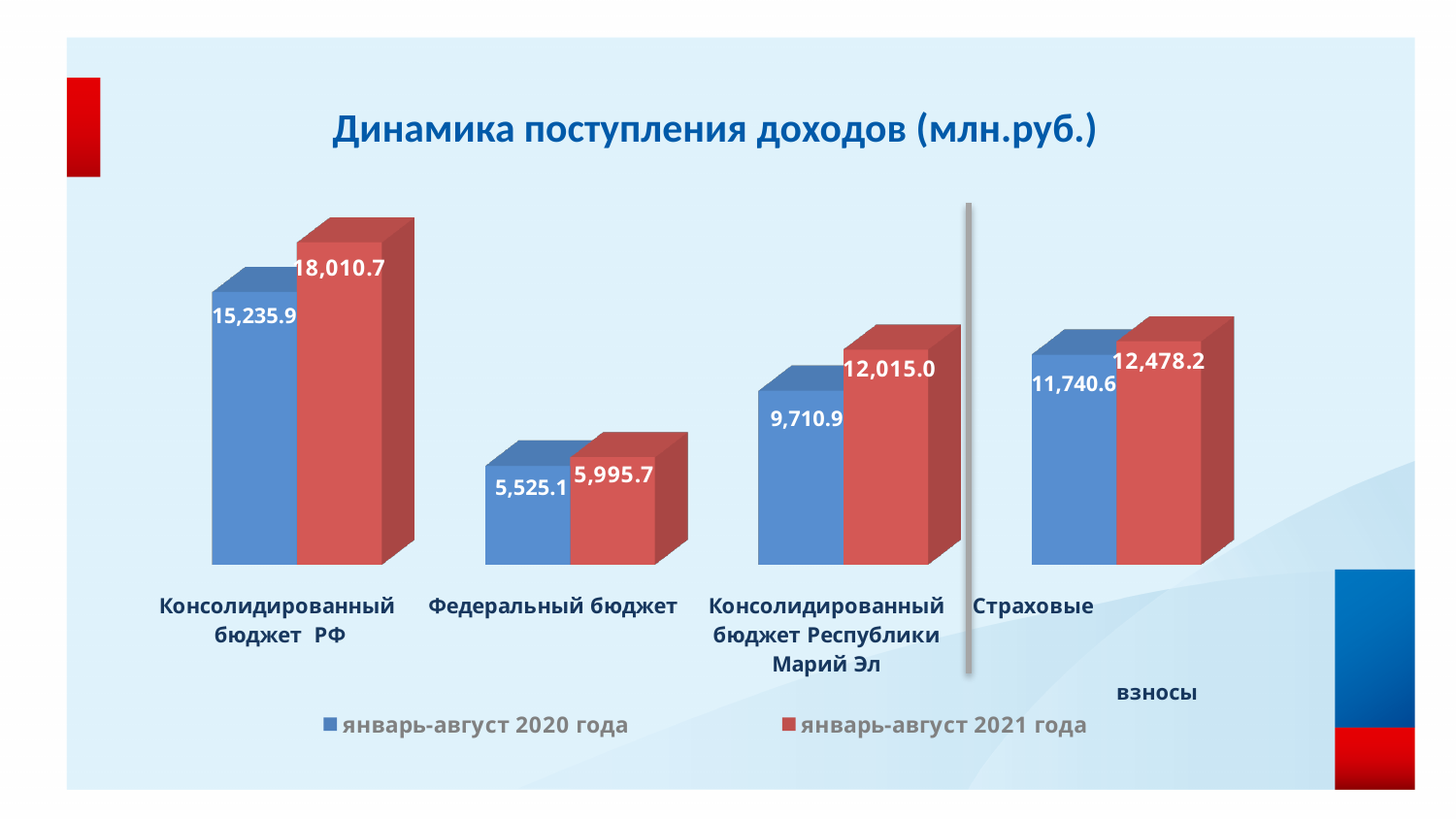
Which category has the highest value in the январь-август 2021 года series? Консолидированный бюджет РФ What kind of chart is shown on the slide? Bar chart What is the value for Консолидированный бюджет Республики Марий Эл in the январь-август 2020 года series? 9,710.9 Which is larger: the январь-август 2020 года value for Страховые взносы or the январь-август 2021 года value for Консолидированный бюджет Республики Марий Эл? январь-август 2021 года value for Консолидированный бюджет Республики Марий Эл What is the difference between the январь-август 2021 года and январь-август 2020 года values for Консолидированный бюджет РФ? 2,774.8 How many categories are shown on the x axis? 4 What is the value for Консолидированный бюджет РФ in the январь-август 2020 года series? 15,235.9 Which category has the lowest value in the январь-август 2020 года series? Федеральный бюджет How many series does the legend list? 2 What is the value for Страховые взносы in the январь-август 2021 года series? 12,478.2 What is the value for Федеральный бюджет in the январь-август 2021 года series? 5,995.7 What is the difference between the январь-август 2021 года and январь-август 2020 года values for Консолидированный бюджет Республики Марий Эл? 2,304.1